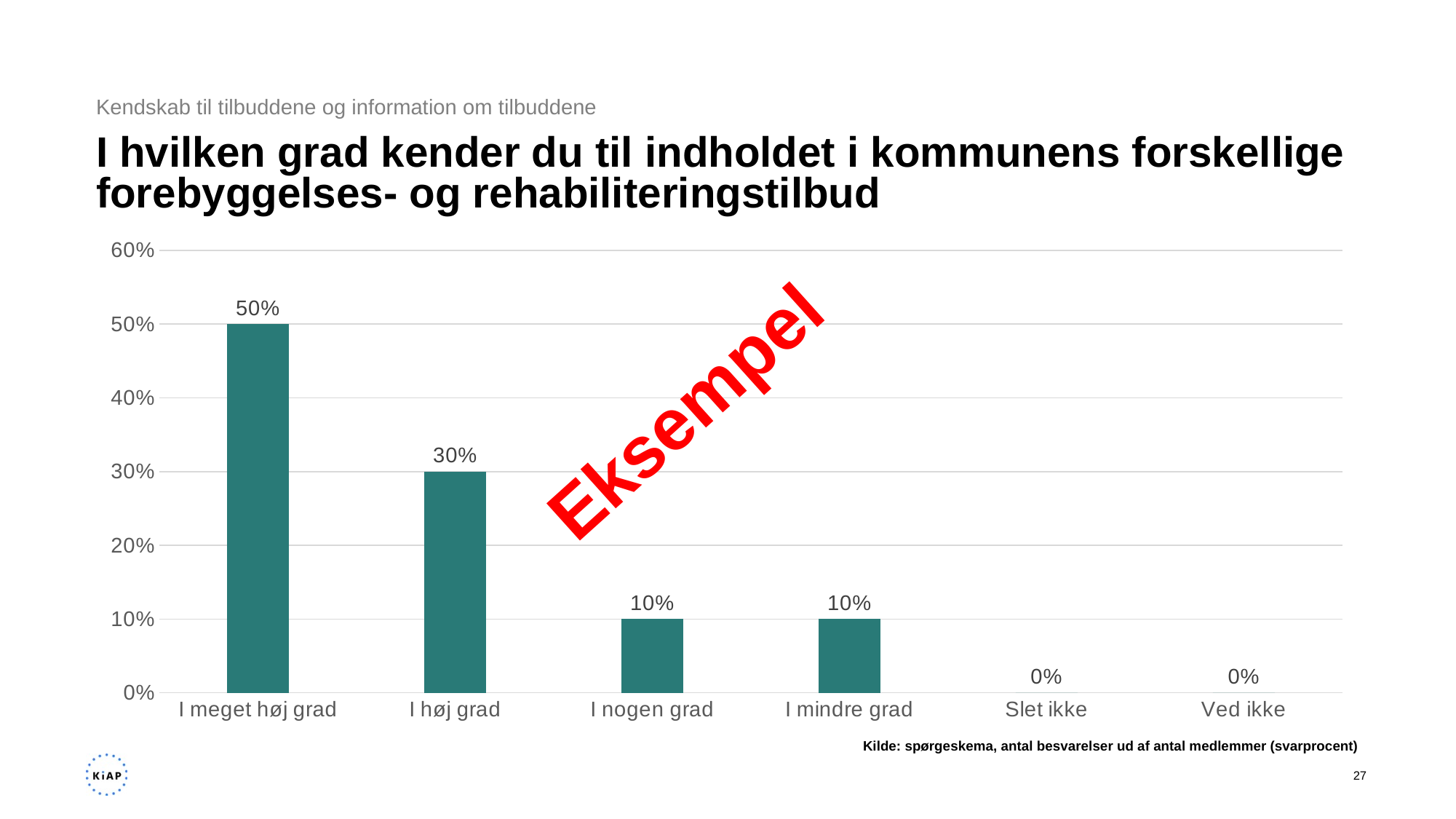
How many categories are shown on the x axis? 6 Is the value for "I meget høj grad" greater or less than 40%? greater Do the values rise or fall from left to right along the x axis? fall What kind of chart is shown on the slide? bar chart Which category has the highest value? I meget høj grad What is the value for "Slet ikke"? 0% Which is larger, the value for "I høj grad" or the value for "I mindre grad"? I høj grad What is the value for "I høj grad"? 30% What is the red diagonal text overlaid on the chart? Eksempel What is the value for "I meget høj grad"? 50% What is the difference between the values for "I meget høj grad" and "I høj grad"? 20% What is the value for "I nogen grad"? 10%